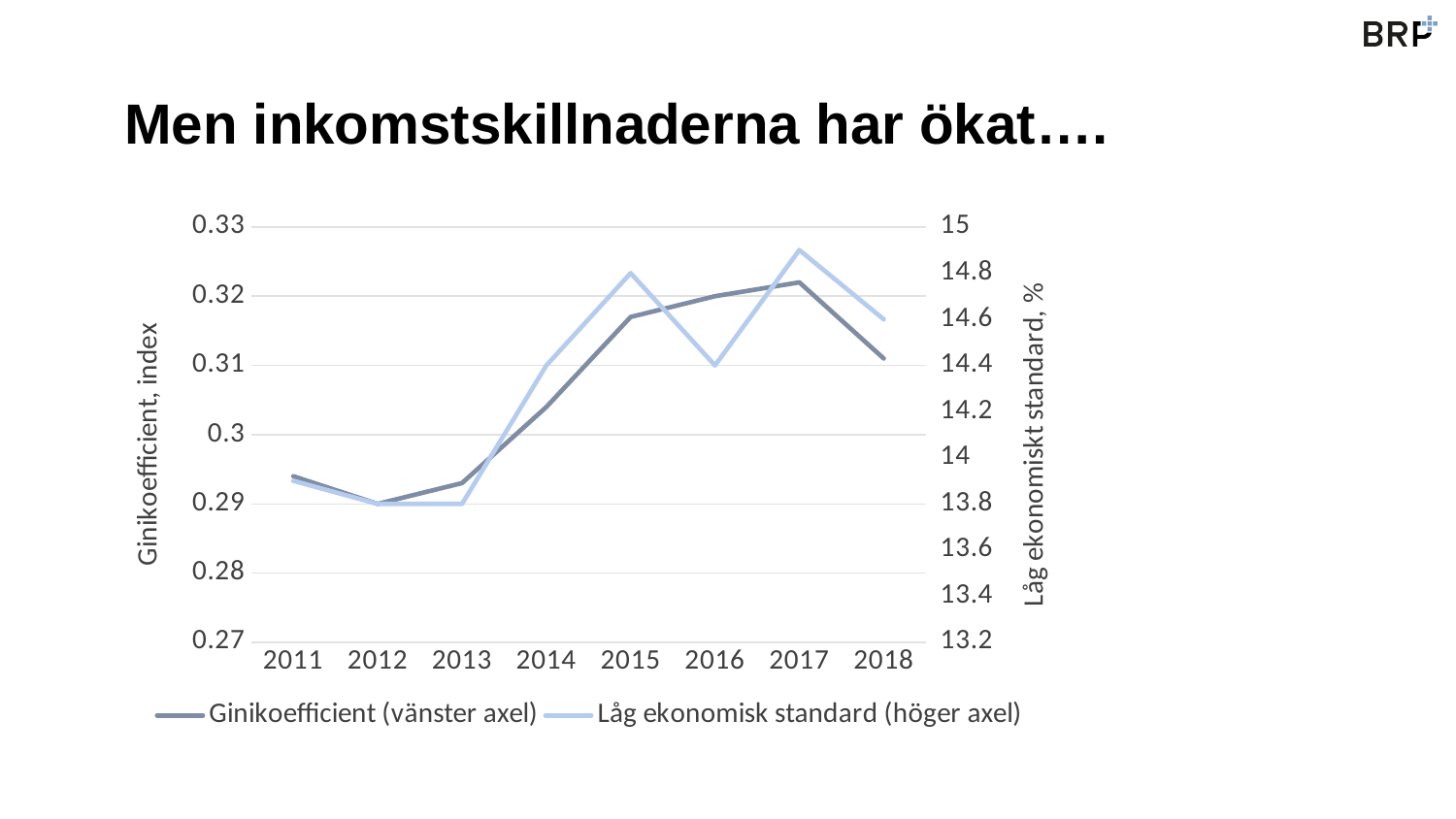
Is the Ginikoefficient value for 2011 greater or less than 0.3? less How many years are shown on the x axis? 8 Is the Ginikoefficient value for 2018 greater or less than 0.3? greater Which is larger, the Låg ekonomisk standard value for 2015 or for 2016? 2015 In which year is the Ginikoefficient highest? 2017 In which year is Låg ekonomisk standard highest? 2017 Which axis does the Låg ekonomisk standard series use, according to the legend? Höger axel (right axis) What kind of chart is shown on the slide? Line chart Is the Låg ekonomisk standard value for 2016 greater or less than 14.6? less How many series does the legend list? 2 In which year is the Ginikoefficient lowest? 2012 Does the Ginikoefficient rise or fall from 2012 to 2017? Rise